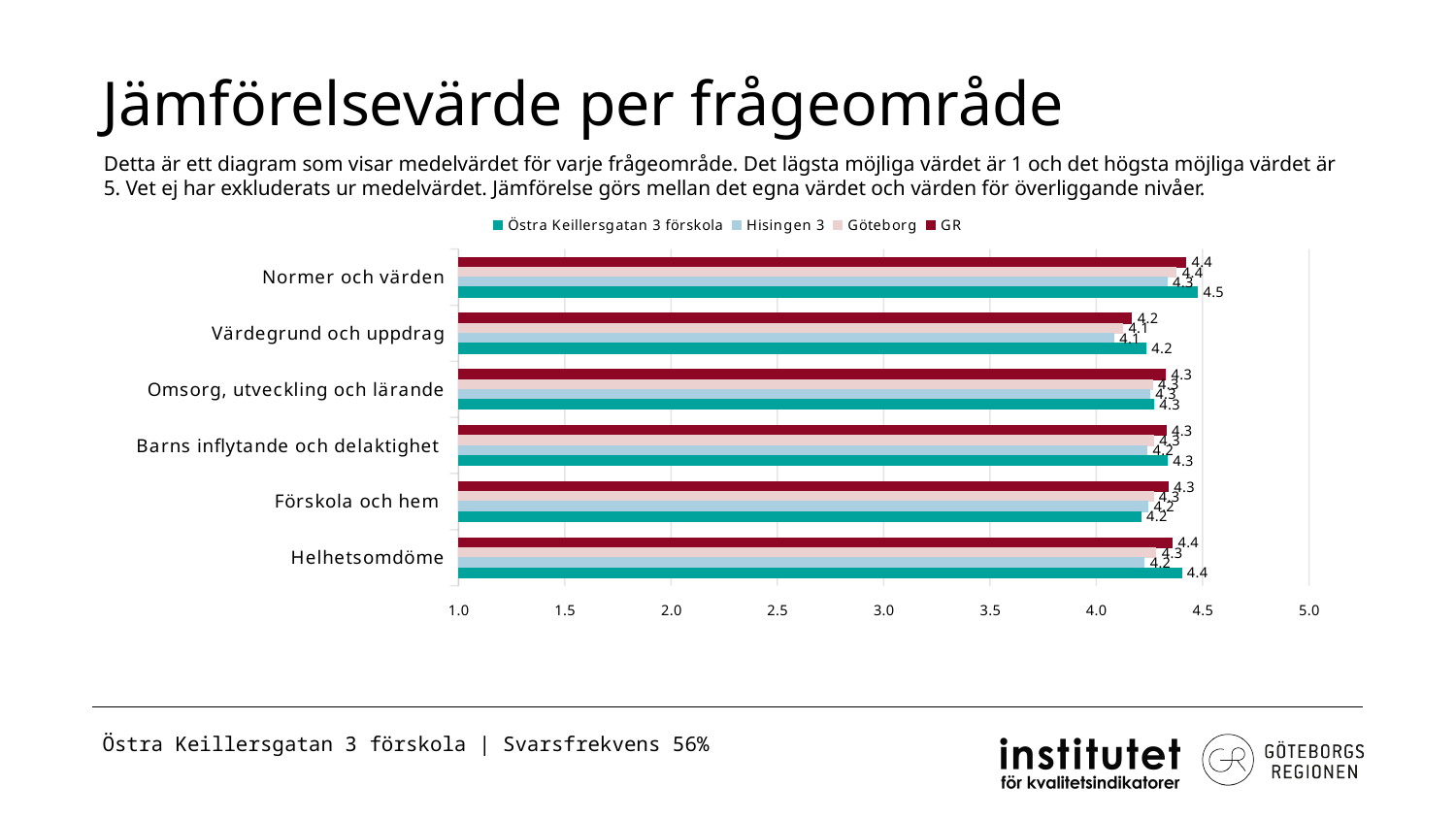
What is the value for Östra Keillersgatan 3 förskola in the category Förskola och hem? 4.2 What is the value for Östra Keillersgatan 3 förskola in the category Normer och värden? 4.5 What is the value for GR in the category Värdegrund och uppdrag? 4.2 What kind of chart is shown on the slide? Bar chart In which category does Östra Keillersgatan 3 förskola have its highest value? Normer och värden In which category does GR have its lowest value? Värdegrund och uppdrag For Normer och värden, which is larger: the value for Östra Keillersgatan 3 förskola or the value for GR? Östra Keillersgatan 3 förskola Is the value for Östra Keillersgatan 3 förskola in Helhetsomdöme greater or less than 4.0? greater How many categories (frågeområden) are shown on the chart? 6 How many series does the legend list? 4 What is the value for GR in the category Helhetsomdöme? 4.4 What is the difference between the Östra Keillersgatan 3 förskola values for Normer och värden and Värdegrund och uppdrag? 0.3